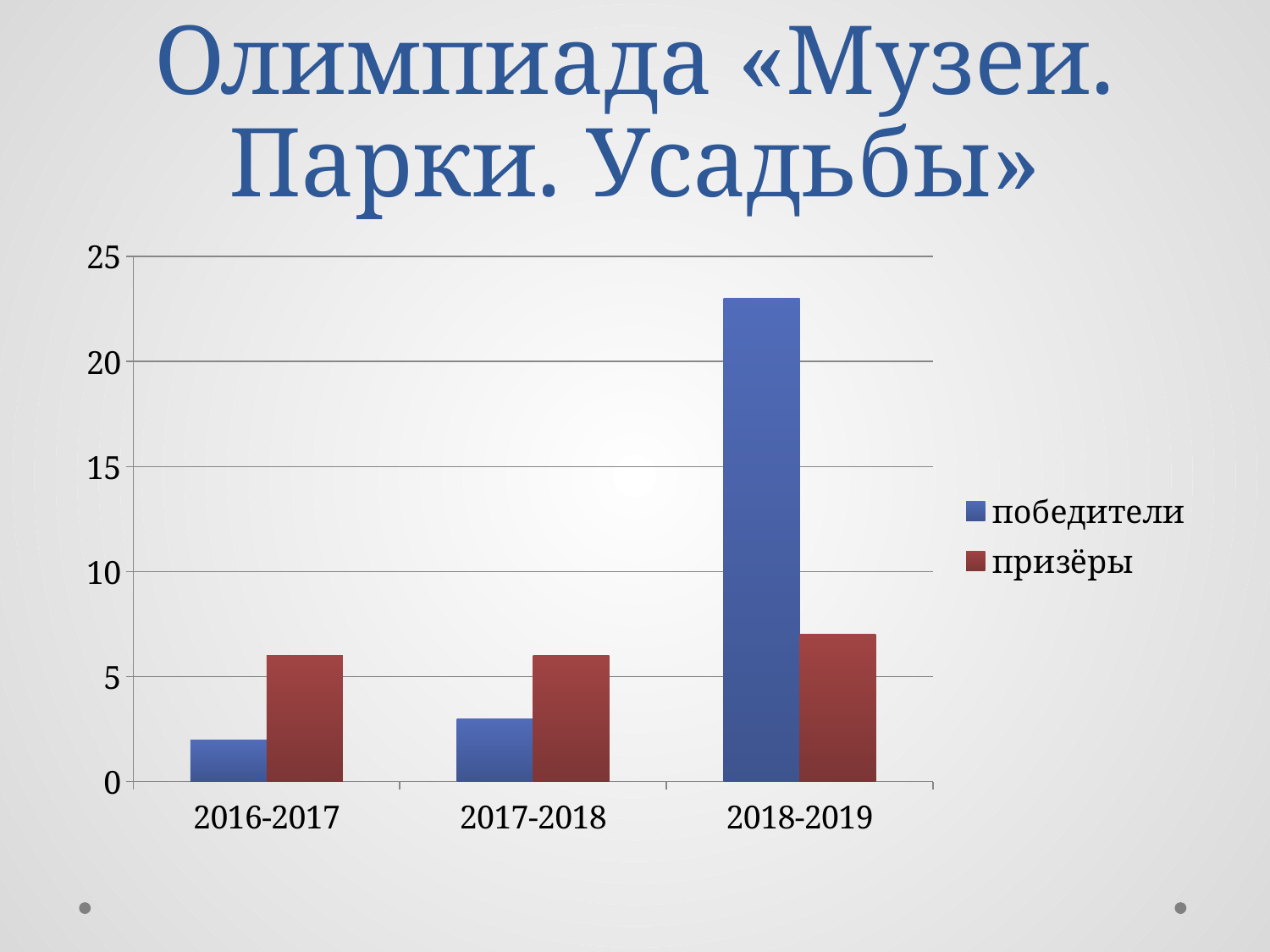
What colour are the bars for призёры? red How many academic-year categories are shown on the x axis? 3 Is the value for призёры in 2017-2018 greater or less than 5? greater Is the value for призёры in 2018-2019 greater or less than 10? less In 2016-2017, which is larger: победители or призёры? призёры Is the value for победители in 2016-2017 greater or less than 5? less Do the values for победители rise or fall from 2016-2017 to 2018-2019? rise How many series does the legend list? 2 In which year is the value for победители highest? 2018-2019 What kind of chart is shown on the slide? bar chart In 2018-2019, which is larger: победители or призёры? победители